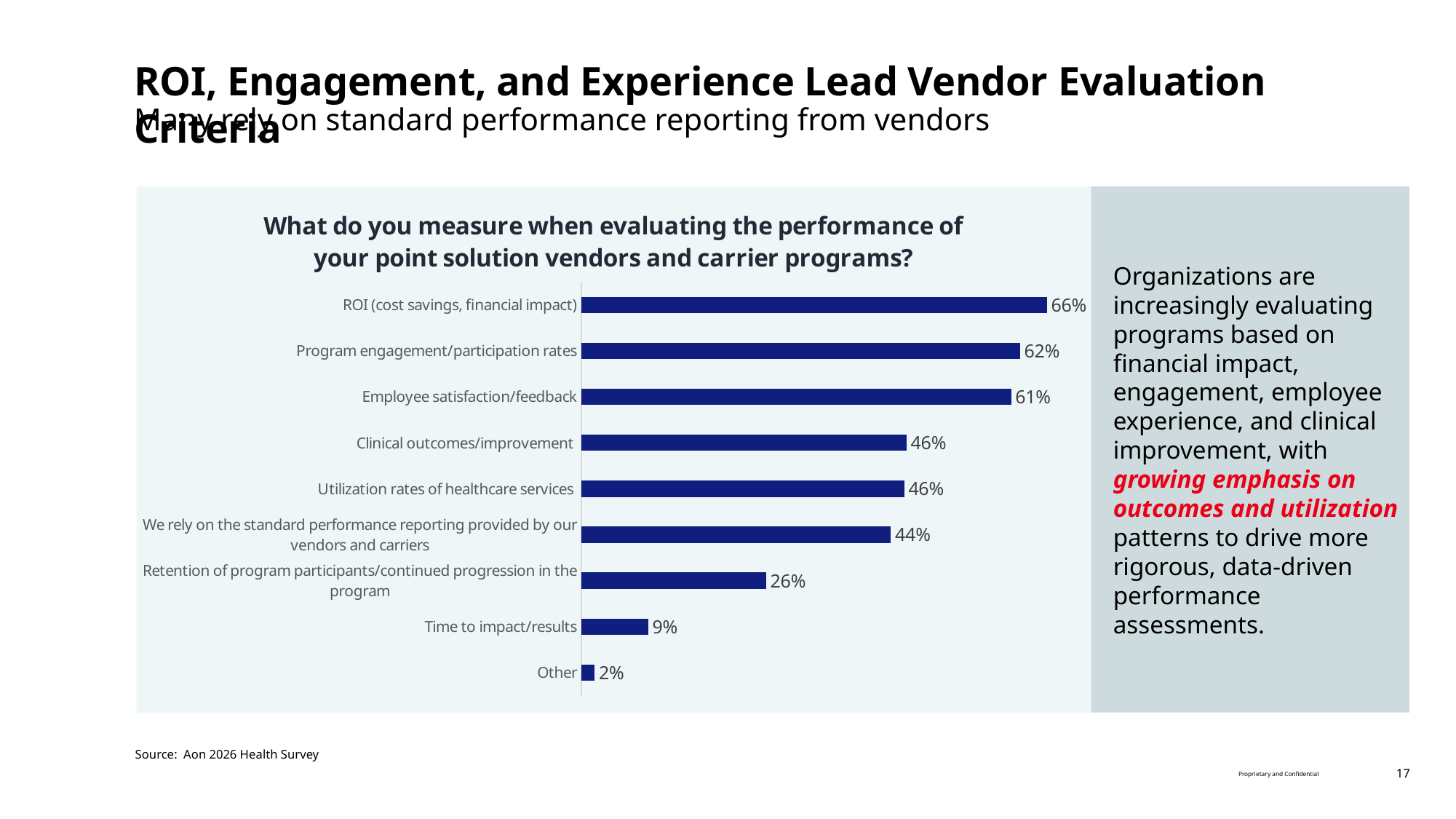
How many categories are shown in the chart? 9 What is the value for Time to impact/results? 9% Which is larger: Program engagement/participation rates or Utilization rates of healthcare services? Program engagement/participation rates What is the value for Retention of program participants/continued progression in the program? 26% What percentage of respondents measure ROI (cost savings, financial impact)? 66% Which category has the lowest value? Other What is the title of the chart? What do you measure when evaluating the performance of your point solution vendors and carrier programs? What kind of chart is shown on the slide? Bar chart What is the difference between ROI (cost savings, financial impact) and Program engagement/participation rates? 4% What is the difference between Clinical outcomes/improvement and Retention of program participants/continued progression in the program? 20% What is the value for Employee satisfaction/feedback? 61% Which category has the highest value? ROI (cost savings, financial impact)